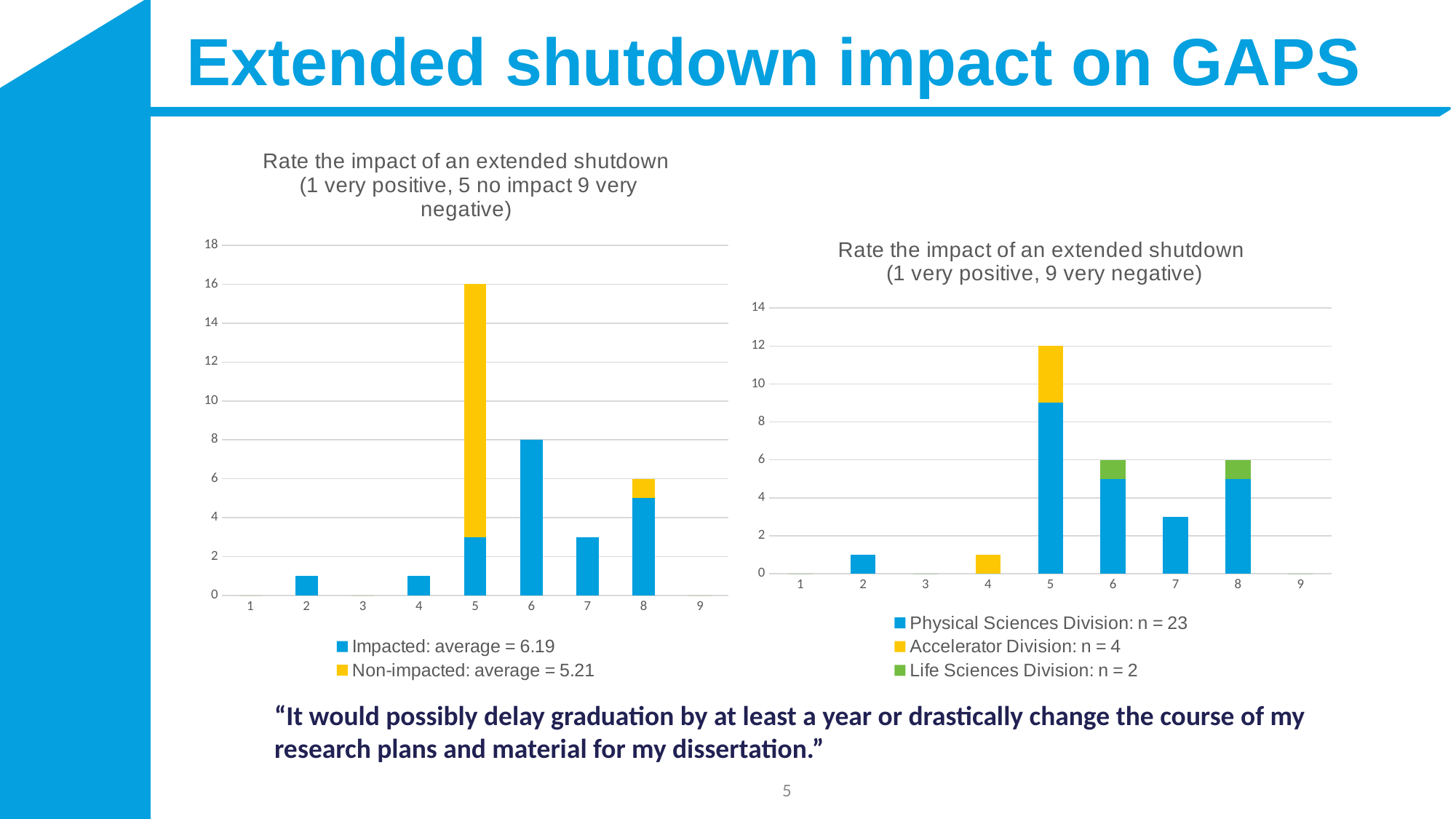
In the left chart, what average is given for the Impacted series in the legend? 6.19 In the right chart, how many series does the legend list? 3 In the left chart, is the value for rating 7 greater or less than 4? less In the right chart, which rating has the tallest stacked bar? 5 In the left chart, how many series does the legend list? 2 What type of chart is the right chart? Stacked bar chart In the left chart, what is the total height of the stacked bar for rating 5? 16 In the left chart, which rating has the tallest stacked bar? 5 In the right chart, which series is shown in green? Life Sciences Division: n = 2 In the right chart, what is the total height of the stacked bar for rating 5? 12 In the left chart, what is the value for rating 6? 8 In the right chart, is the Physical Sciences Division value for rating 5 greater or less than 8? greater